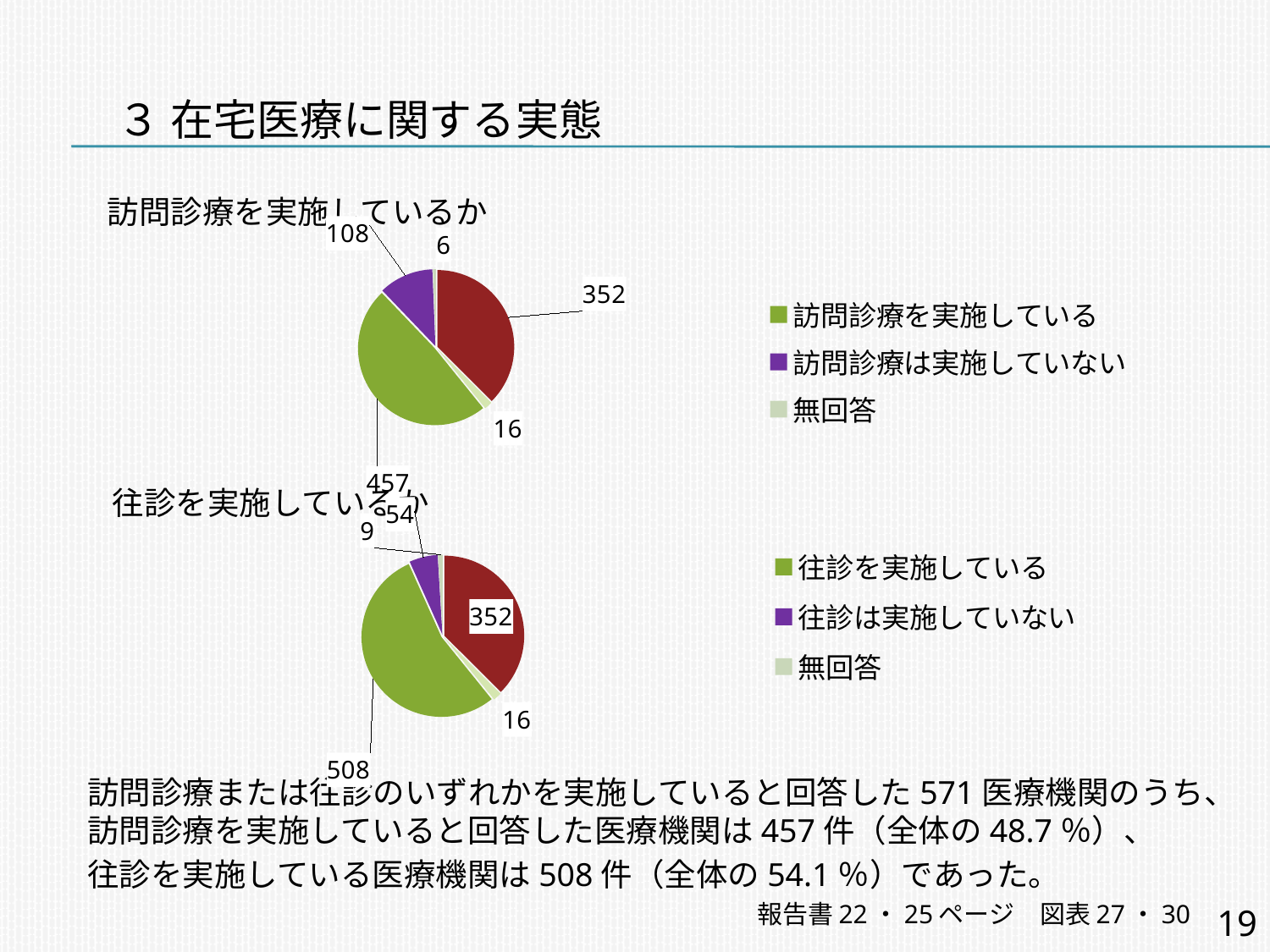
In the bottom pie chart (往診を実施しているか), what is the difference between 往診を実施している and 往診は実施していない? 454 In the top pie chart (訪問診療を実施しているか), what is the difference between 訪問診療を実施している and 訪問診療は実施していない? 349 What kind of chart is used for 訪問診療を実施しているか? Pie chart In the top pie chart (訪問診療を実施しているか), what is the value for 訪問診療を実施している? 457 In the top pie chart (訪問診療を実施しているか), what is the value for 訪問診療は実施していない? 108 In the bottom pie chart (往診を実施しているか), which legend category has the largest slice? 往診を実施している In the bottom pie chart (往診を実施しているか), what is the value for 往診を実施している? 508 How many entries does the legend of the top pie chart (訪問診療を実施しているか) list? 3 In the top pie chart (訪問診療を実施しているか), which legend category has the largest slice? 訪問診療を実施している How many data labels are shown on the bottom pie chart (往診を実施しているか)? 5 Which is larger: 訪問診療を実施している in the top chart or 往診を実施している in the bottom chart? 往診を実施している In the bottom pie chart (往診を実施しているか), what is the value for 往診は実施していない? 54